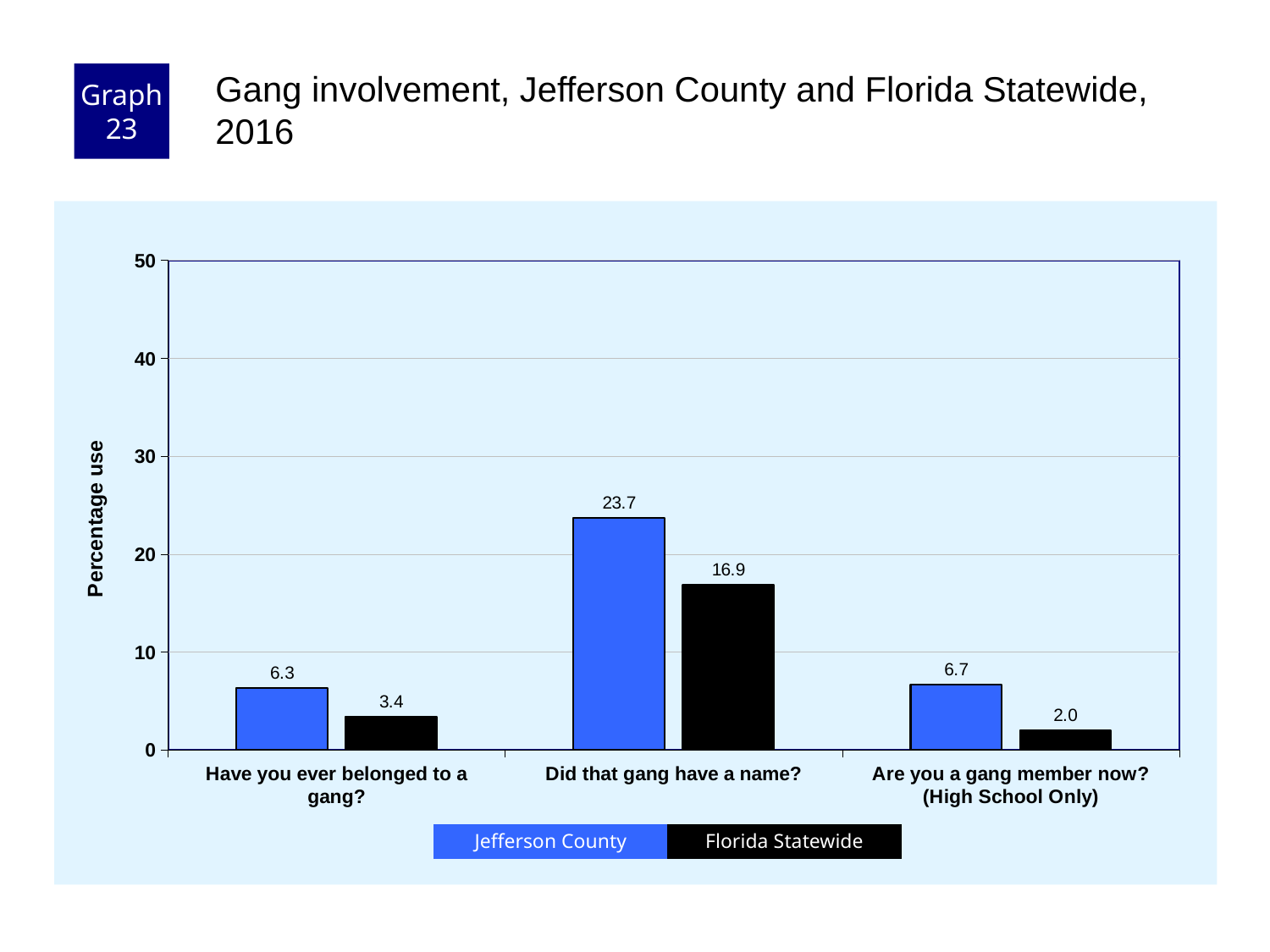
How many series does the legend list? 2 What is the difference between the Jefferson County and Florida Statewide values for "Did that gang have a name?"? 6.8 For "Are you a gang member now? (High School Only)", which is larger: Jefferson County or Florida Statewide? Jefferson County How many question categories are shown on the x axis? 3 What kind of chart is shown on the slide? bar chart What is the Florida Statewide value for "Have you ever belonged to a gang?"? 3.4 Which question has the highest Jefferson County value? Did that gang have a name? What is the Florida Statewide value for "Are you a gang member now? (High School Only)"? 2.0 Is the Florida Statewide value for "Did that gang have a name?" greater or less than 20? less Which question has the lowest Florida Statewide value? Are you a gang member now? (High School Only) What is the label of the y axis? Percentage use What is the Jefferson County value for "Did that gang have a name?"? 23.7